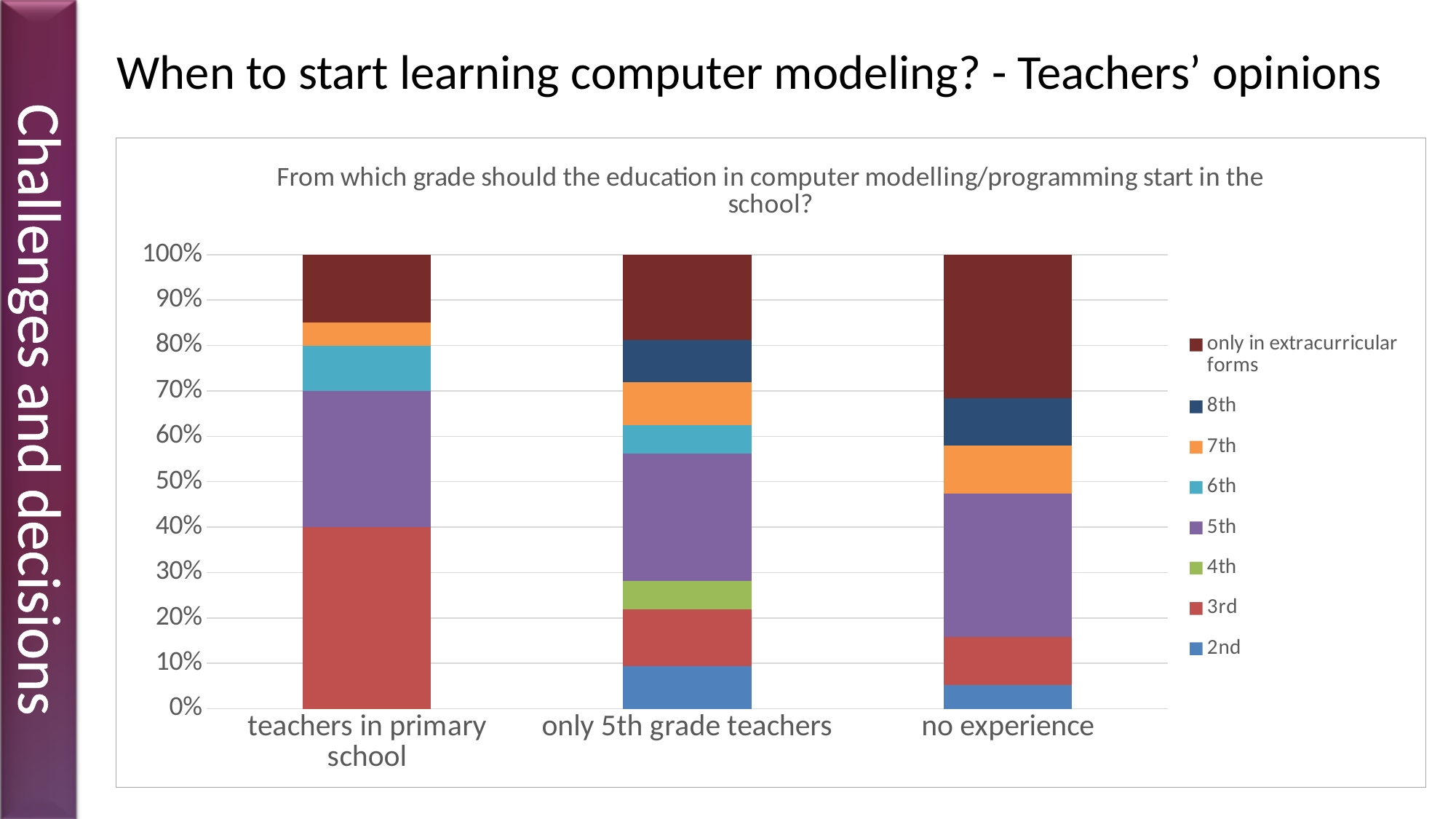
How many series does the chart's legend list? 8 Which legend entry is shown in purple? 5th Which category has the larger share for 'only in extracurricular forms': teachers in primary school or no experience? no experience What is the title of the chart? From which grade should the education in computer modelling/programming start in the school? Is the share for '2nd' among teachers with no experience greater or less than 10%? less Is the share for '5th' among only 5th grade teachers greater or less than 20%? greater Is the share for 'only in extracurricular forms' among teachers with no experience greater or less than 20%? greater Which category has the larger share for '3rd': teachers in primary school or no experience? teachers in primary school How many categories are shown on the x axis of the chart? 3 What kind of chart is shown on the slide? stacked bar chart